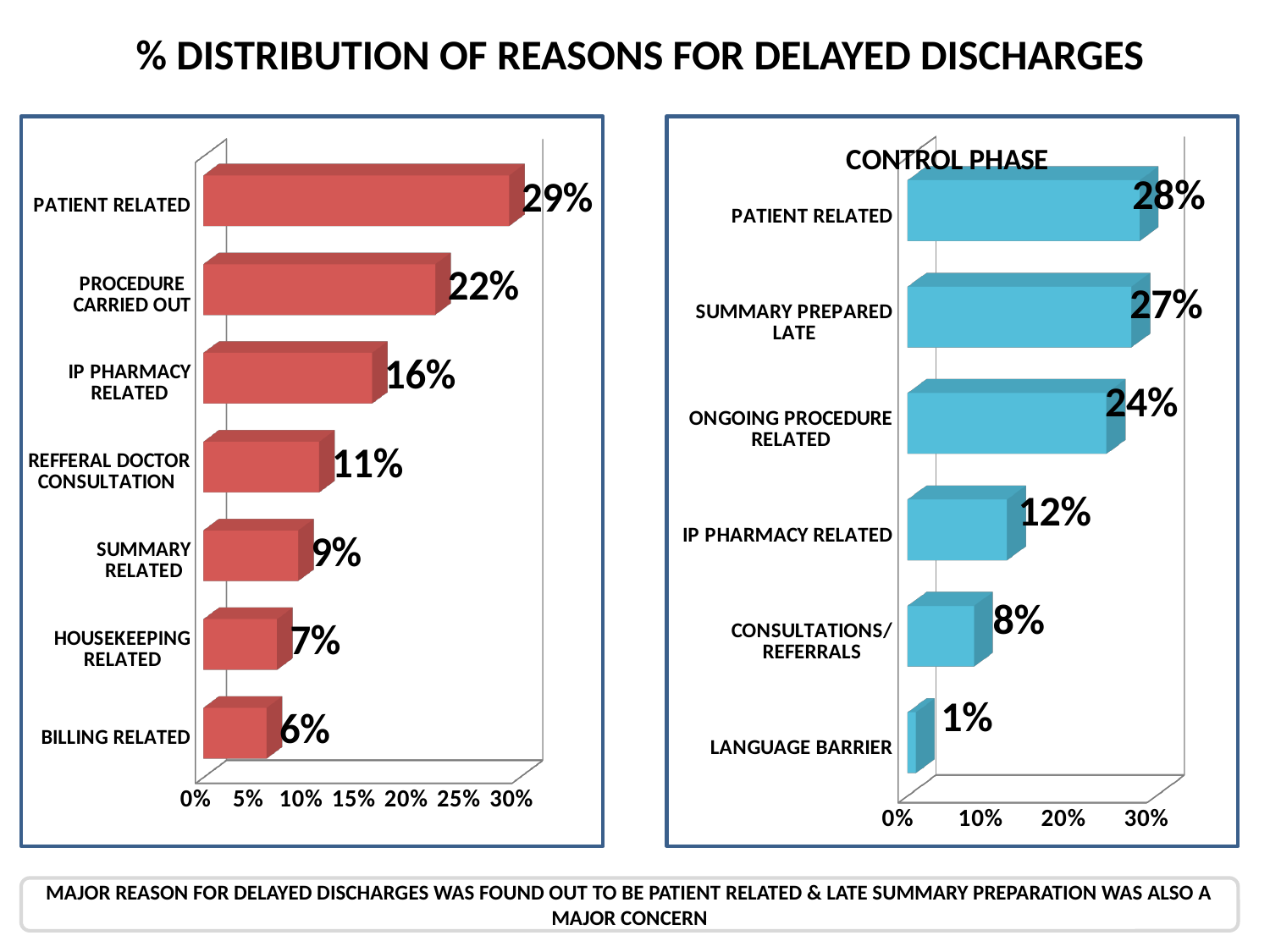
In the CONTROL PHASE chart, which category has the highest value? PATIENT RELATED In the left chart, what is the difference between PROCEDURE CARRIED OUT and IP PHARMACY RELATED? 6% How many categories does the CONTROL PHASE chart show? 6 In the CONTROL PHASE chart, what is the value for SUMMARY PREPARED LATE? 27% In the left chart, what is the value for PATIENT RELATED? 29% What kind of chart is the CONTROL PHASE chart? Bar chart What is the value for IP PHARMACY RELATED in the CONTROL PHASE chart? 12% In the left chart, which is larger: SUMMARY RELATED or HOUSEKEEPING RELATED? SUMMARY RELATED In the CONTROL PHASE chart, what is the difference between ONGOING PROCEDURE RELATED and IP PHARMACY RELATED? 12% How many categories does the left chart show? 7 In the CONTROL PHASE chart, which category has the lowest value? LANGUAGE BARRIER In the left chart, which category has the lowest value? BILLING RELATED